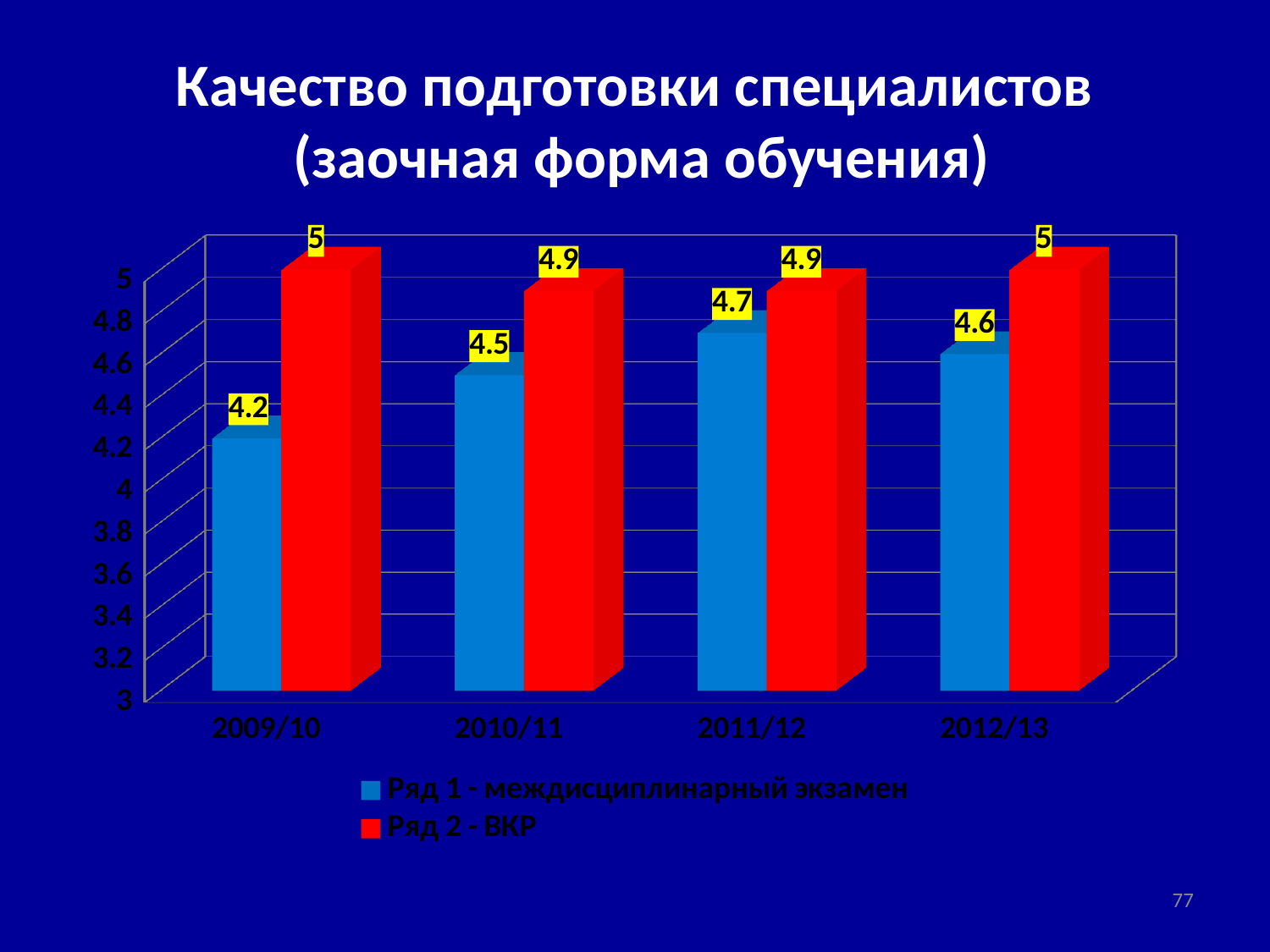
What colour are the bars for Ряд 2 - ВКР? red Which is larger in 2011/12: Ряд 1 - междисциплинарный экзамен or Ряд 2 - ВКР? Ряд 2 - ВКР How many academic years are shown on the x axis? 4 What is the difference between Ряд 2 - ВКР and Ряд 1 - междисциплинарный экзамен in 2009/10? 0.8 How many series does the legend list? 2 What is the value for Ряд 1 - междисциплинарный экзамен in 2012/13? 4.6 What kind of chart is shown on the slide? bar chart What is the value for Ряд 1 - междисциплинарный экзамен in 2009/10? 4.2 In which year is the value for Ряд 1 - междисциплинарный экзамен highest? 2011/12 What is the value for Ряд 2 - ВКР in 2010/11? 4.9 Is the value for Ряд 1 - междисциплинарный экзамен in 2010/11 greater or less than 4? greater In which year is the value for Ряд 1 - междисциплинарный экзамен lowest? 2009/10